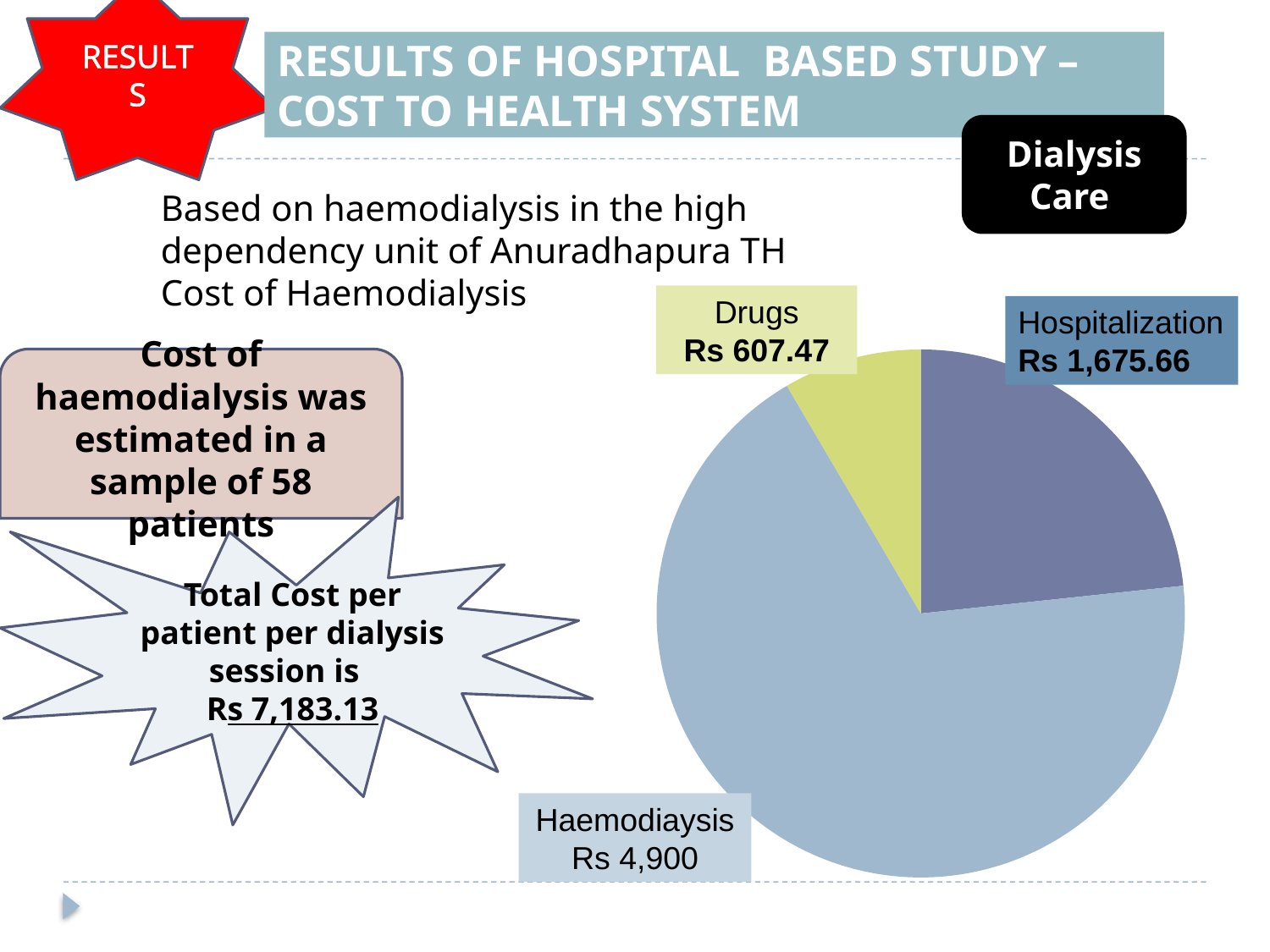
What colour is the Drugs slice in the pie chart? Yellow-green What is the cost shown for Hospitalization in the pie chart? Rs 1,675.66 What is the total cost per patient per dialysis session stated on the slide? Rs 7,183.13 What is the difference between the Hospitalization cost and the Drugs cost in the pie chart? Rs 1,068.19 Which category has the largest slice of the pie chart? Haemodialysis What is the cost shown for Drugs in the pie chart? Rs 607.47 What type of chart is shown on the slide? Pie chart How many slices does the pie chart have? 3 Which is larger in the pie chart, the cost for Hospitalization or the cost for Drugs? Hospitalization What is the cost shown for Haemodialysis in the pie chart? Rs 4,900 What is the difference between the Haemodialysis cost and the Hospitalization cost in the pie chart? Rs 3,224.34 Which category has the smallest slice of the pie chart? Drugs